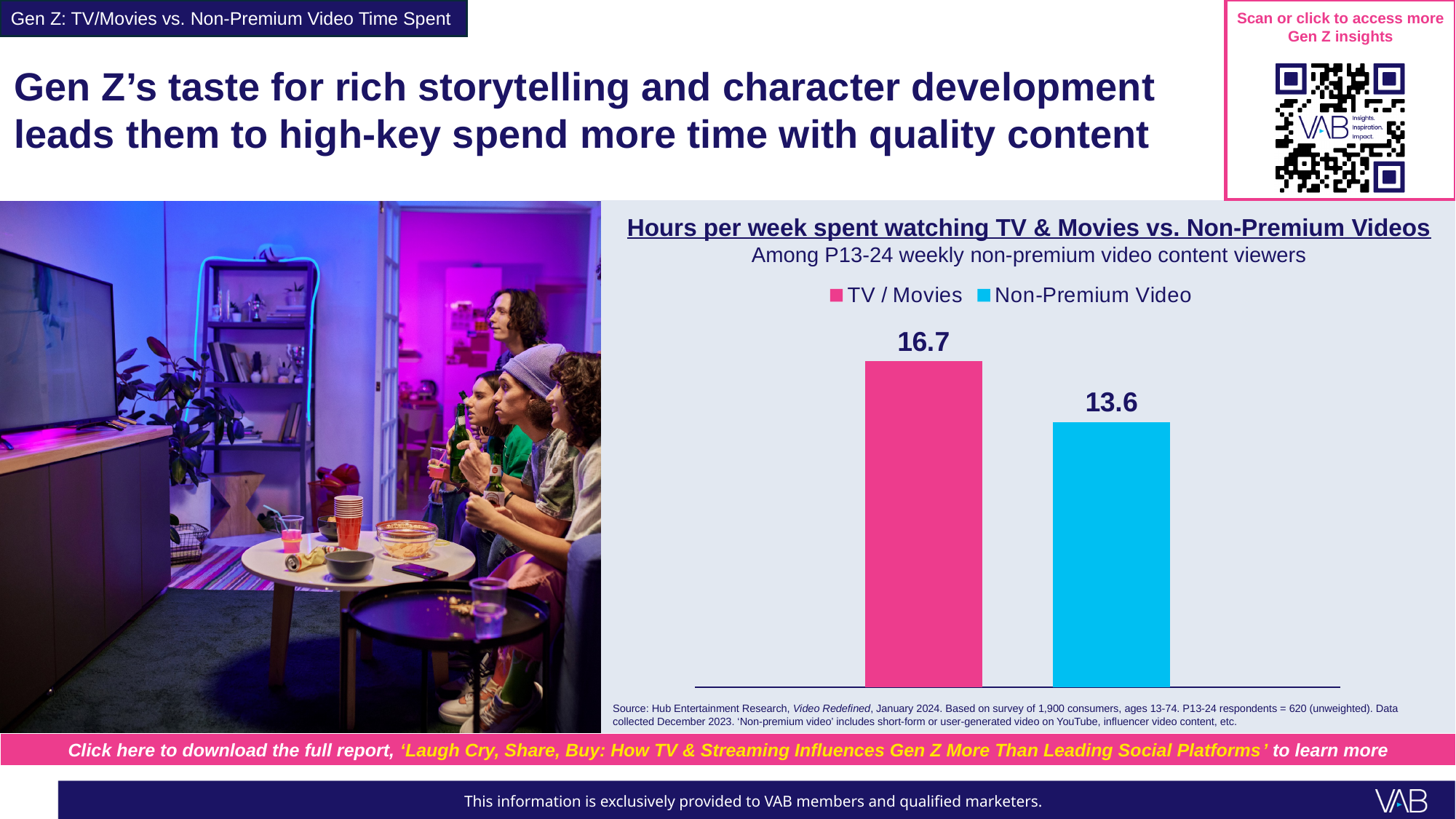
How many entries does the chart legend list? 2 What is the value for TV / Movies in the chart? 16.7 What is the title of the chart? Hours per week spent watching TV & Movies vs. Non-Premium Videos What kind of chart is shown on the slide? Bar chart What is the value for Non-Premium Video in the chart? 13.6 What colour is the Non-Premium Video bar in the chart? Blue What is the difference between the TV / Movies value and the Non-Premium Video value? 3.1 Which is larger, the value for TV / Movies or the value for Non-Premium Video? TV / Movies Which category has the highest value in the chart? TV / Movies How many bars are plotted in the chart? 2 Which category has the lowest value in the chart? Non-Premium Video